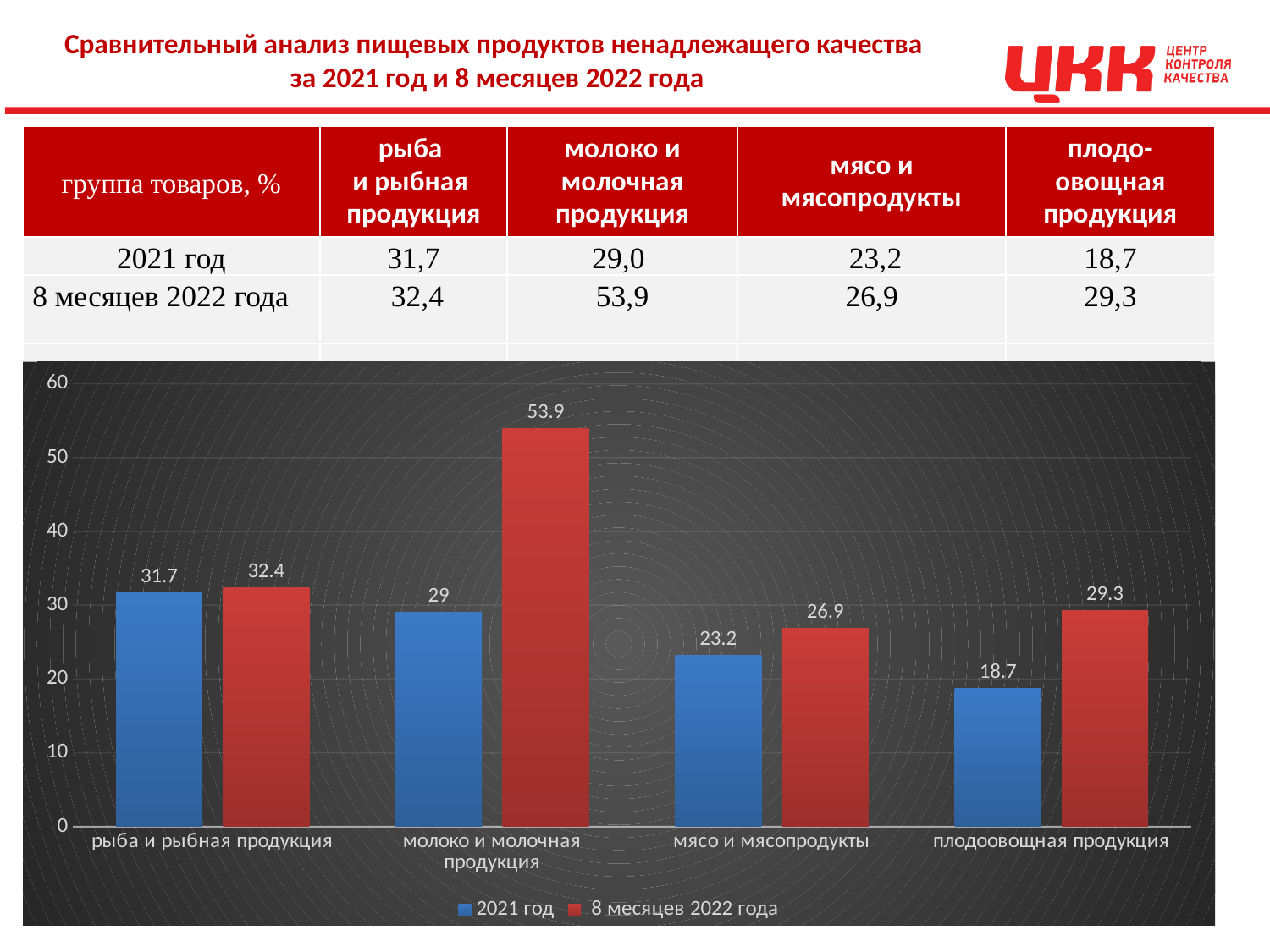
Which category has the lowest value in the '2021 год' series? плодоовощная продукция What colour are the bars for the '2021 год' series? blue How many product categories are shown on the x axis of the chart? 4 Which is larger for 'рыба и рыбная продукция': the '2021 год' value or the '8 месяцев 2022 года' value? 8 месяцев 2022 года Which category has the highest value in the '8 месяцев 2022 года' series? молоко и молочная продукция What type of chart is shown on the slide? bar chart What is the value for 'плодоовощная продукция' in the '2021 год' series? 18.7 What is the value for 'мясо и мясопродукты' in the '8 месяцев 2022 года' series? 26.9 How many series does the chart legend list? 2 What is the value for 'молоко и молочная продукция' in the '8 месяцев 2022 года' series? 53.9 What is the difference between the '8 месяцев 2022 года' and '2021 год' values for 'молоко и молочная продукция'? 24.9 Is the '2021 год' value for 'мясо и мясопродукты' greater or less than 30? less